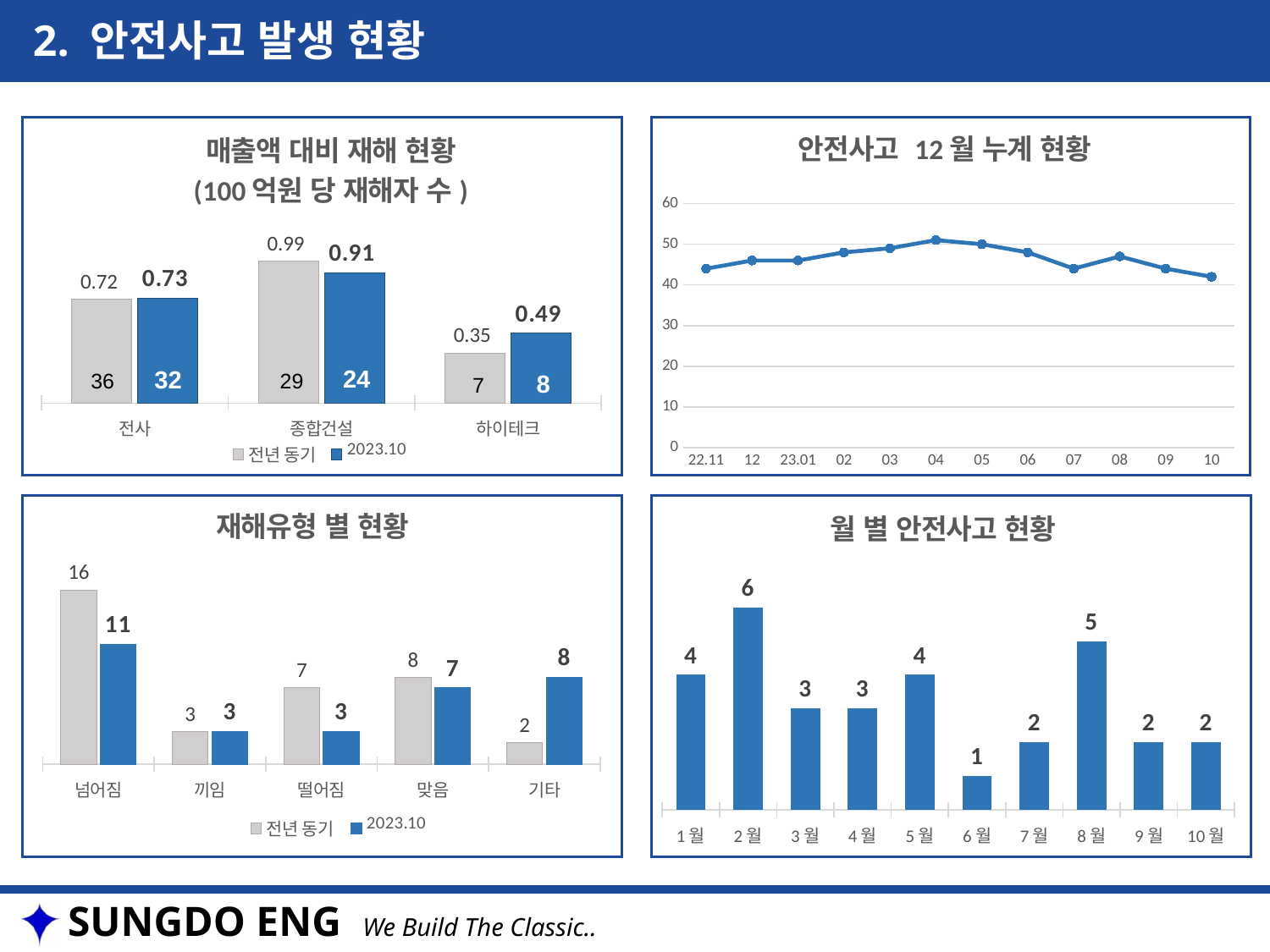
In the '재해유형 별 현황' chart, how many series does the legend list? 2 In the '재해유형 별 현황' chart, which category has the highest 전년 동기 value? 넘어짐 In the '매출액 대비 재해 현황' chart, what is the 전년 동기 rate label for 종합건설? 0.99 In the '안전사고 12월 누계 현황' chart, is the value for 10 greater or less than 50? less In the '월 별 안전사고 현황' chart, what is the difference between the values for 8월 and 7월? 3 In the '월 별 안전사고 현황' chart, how many months are shown on the x axis? 10 In the '재해유형 별 현황' chart, which is larger for 떨어짐: the 전년 동기 value or the 2023.10 value? 전년 동기 In the '매출액 대비 재해 현황' chart, what is the 2023.10 rate label for 하이테크? 0.49 What kind of chart is the '안전사고 12월 누계 현황' chart? line chart In the '월 별 안전사고 현황' chart, what is the value for 6월? 1 In the '월 별 안전사고 현황' chart, which month has the highest value? 2월 In the '재해유형 별 현황' chart, what is the 2023.10 value for 기타? 8